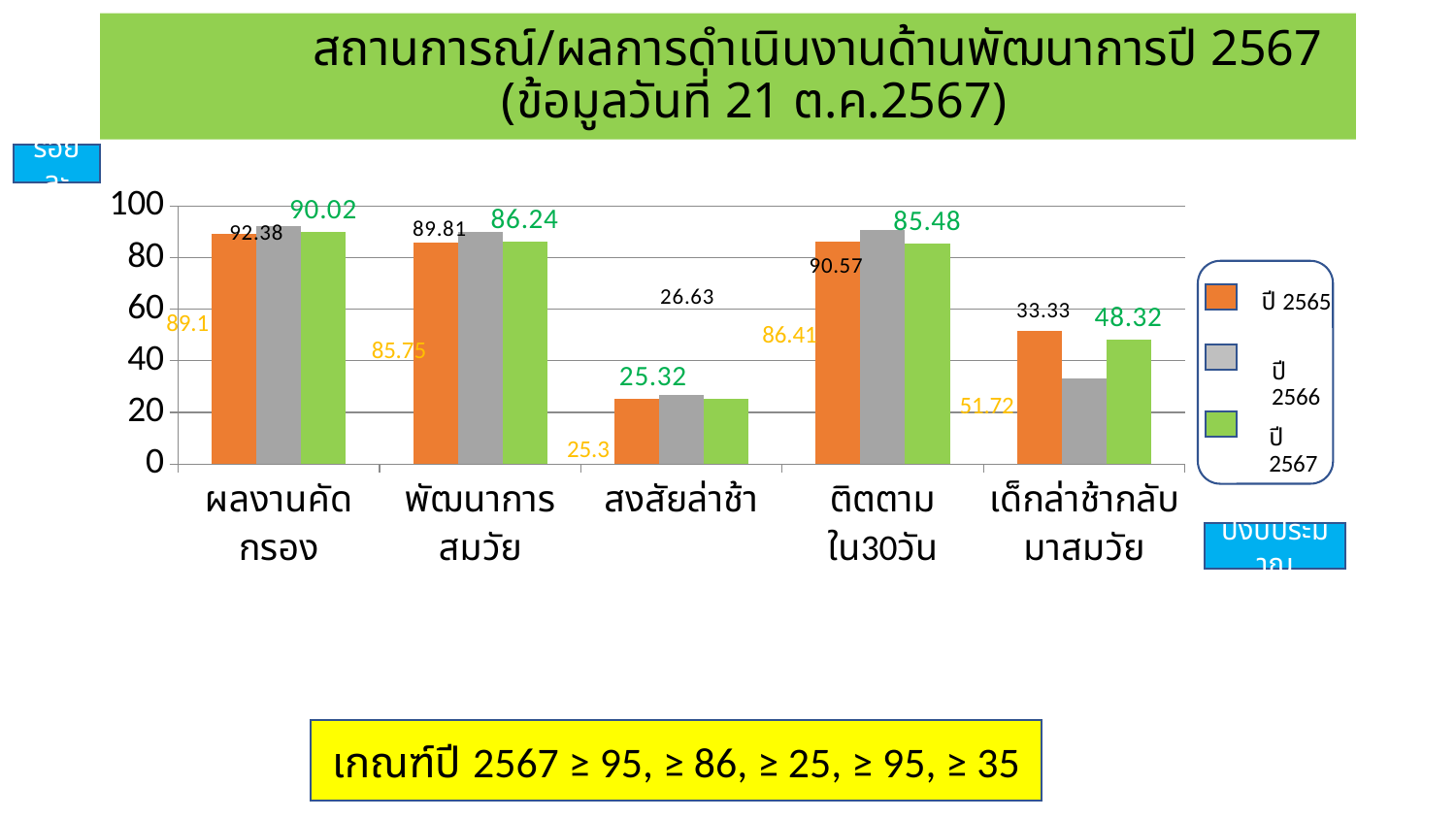
What is the value for ปี 2565 in the category ติดตามใน30วัน? 86.41 How many categories are shown on the x axis? 5 Which category has the highest value for ปี 2566? ผลงานคัดกรอง Which colour represents ปี 2565 in the legend? orange What is the value for ปี 2566 in the category พัฒนาการสมวัย? 89.81 In the category ติดตามใน30วัน, which is larger: the value for ปี 2566 or ปี 2567? ปี 2566 What type of chart is shown on the slide? bar chart Which category has the lowest value for ปี 2567? สงสัยล่าช้า How many series does the legend list? 3 What is the difference between the ปี 2566 and ปี 2567 values in the category เด็กล่าช้ากลับมาสมวัย? 14.99 What is the value for ปี 2567 in the category ผลงานคัดกรอง? 90.02 What is the value for ปี 2567 in the category เด็กล่าช้ากลับมาสมวัย? 48.32